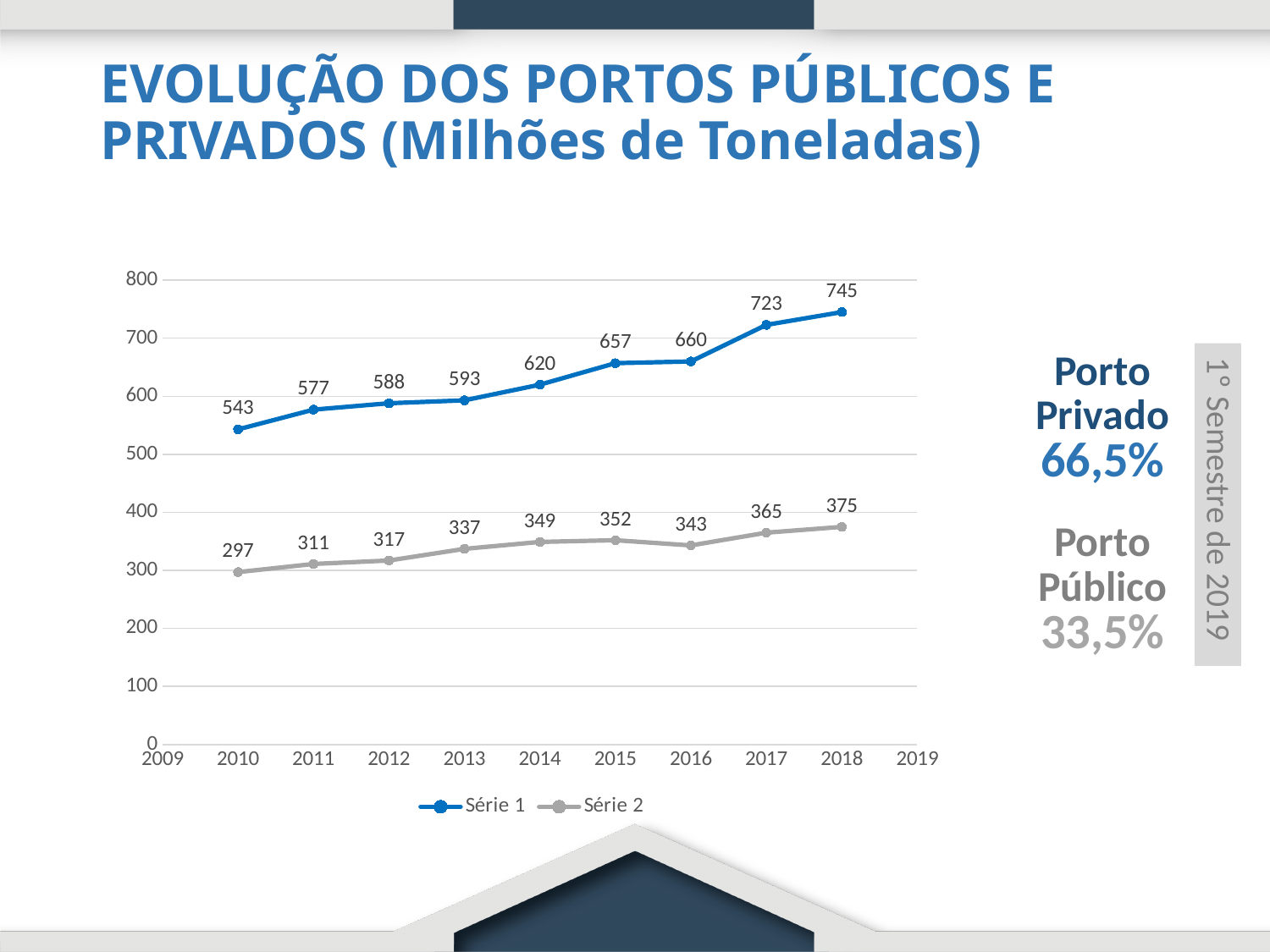
In which year does Série 1 have its lowest value? 2010 In which year does Série 2 reach its highest value? 2018 Which is larger: Série 2 in 2015 or Série 2 in 2016? Série 2 in 2015 What is the value of Série 1 in 2014? 620 What is the difference between Série 1 and Série 2 in 2017? 358 Does Série 1 generally rise or fall from 2010 to 2018? rise What is the value of Série 2 in 2010? 297 How many series does the legend list? 2 Is the value of Série 1 in 2012 greater or less than 500? greater What kind of chart is shown on the slide? line chart What is the value of Série 1 in 2018? 745 How many data points are plotted for Série 1? 9